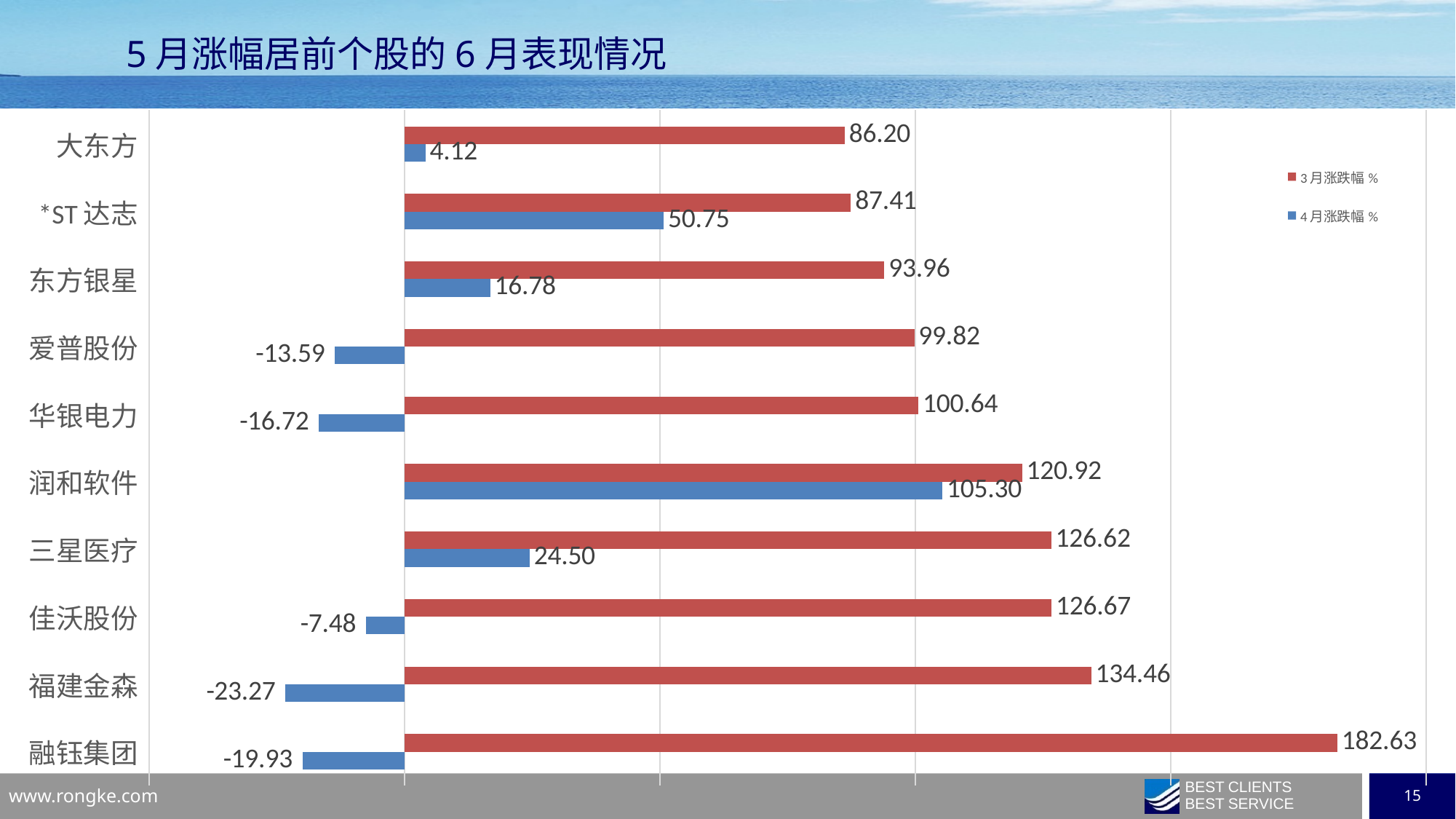
Which stock has the highest 3月涨跌幅% value? 融钰集团 What is the 4月涨跌幅% value for *ST达志? 50.75 What kind of chart is shown on the slide? Bar chart Which stock has the highest 4月涨跌幅% value? 润和软件 Which stock has the lowest 4月涨跌幅% value? 福建金森 What is the difference between the 3月涨跌幅% and 4月涨跌幅% values for 润和软件? 15.62 What is the 4月涨跌幅% value for 福建金森? -23.27 How many stocks are shown on the chart? 10 Which colour represents the 4月涨跌幅% series? Blue What is the 3月涨跌幅% value for 融钰集团? 182.63 Which is larger: the 4月涨跌幅% value for 三星医疗 or for 东方银星? 三星医疗 How many series does the legend list? 2